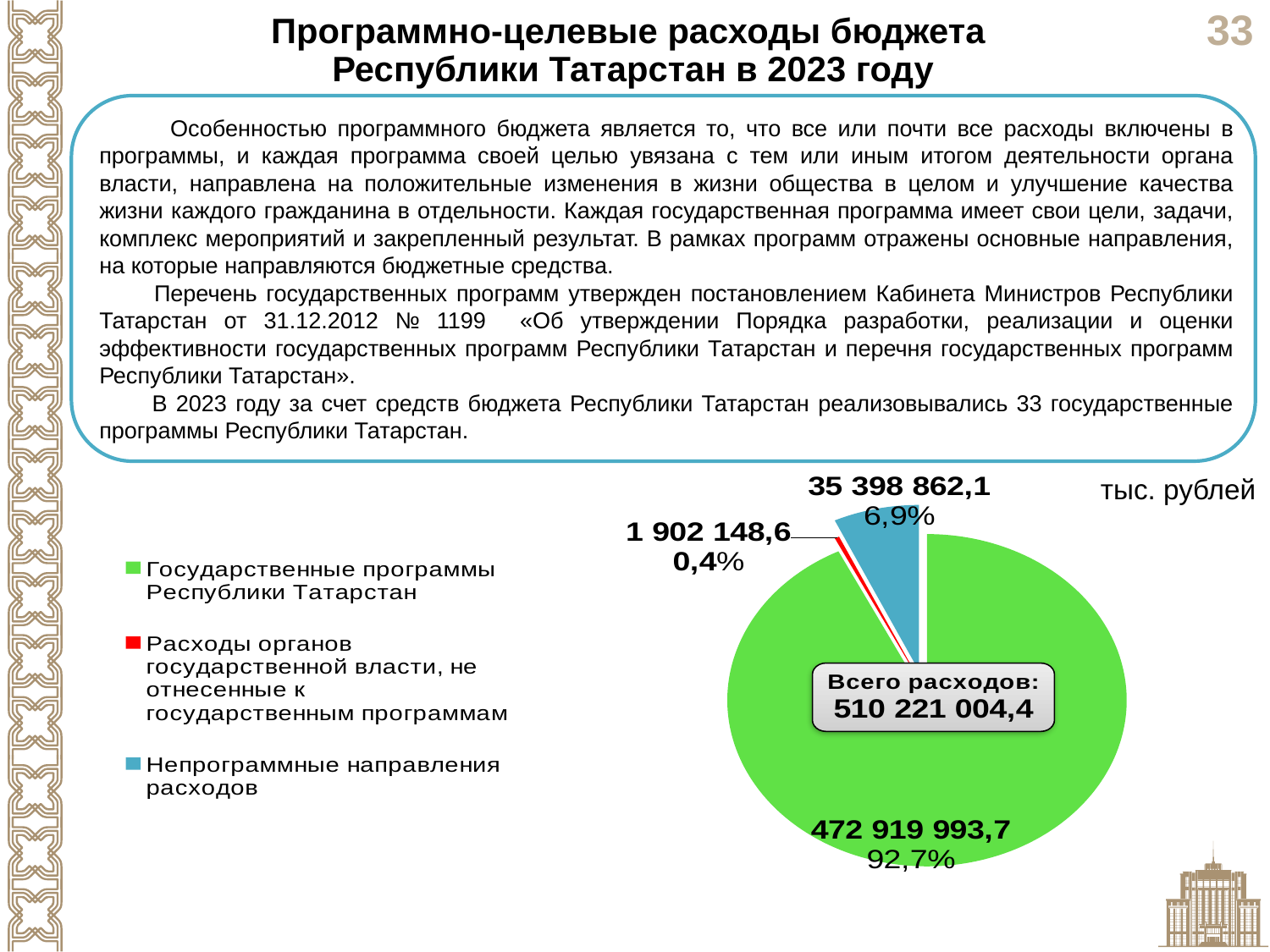
Which is larger: Непрограммные направления расходов or Расходы органов государственной власти, не отнесенные к государственным программам? Непрограммные направления расходов What kind of chart is shown on the slide? pie chart What is the value for Государственные программы Республики Татарстан? 472 919 993,7 What is the value for Расходы органов государственной власти, не отнесенные к государственным программам? 1 902 148,6 What is the value for Непрограммные направления расходов? 35 398 862,1 How many entries does the legend of the pie chart list? 3 How many slices does the pie chart have? 3 Which category has the largest slice of the pie? Государственные программы Республики Татарстан Which category has the smallest slice of the pie? Расходы органов государственной власти, не отнесенные к государственным программам What total expenditure (Всего расходов) is shown in the centre of the pie chart? 510 221 004,4 What share of the pie does Государственные программы Республики Татарстан take? 92,7% What share of the pie does Непрограммные направления расходов take? 6,9%